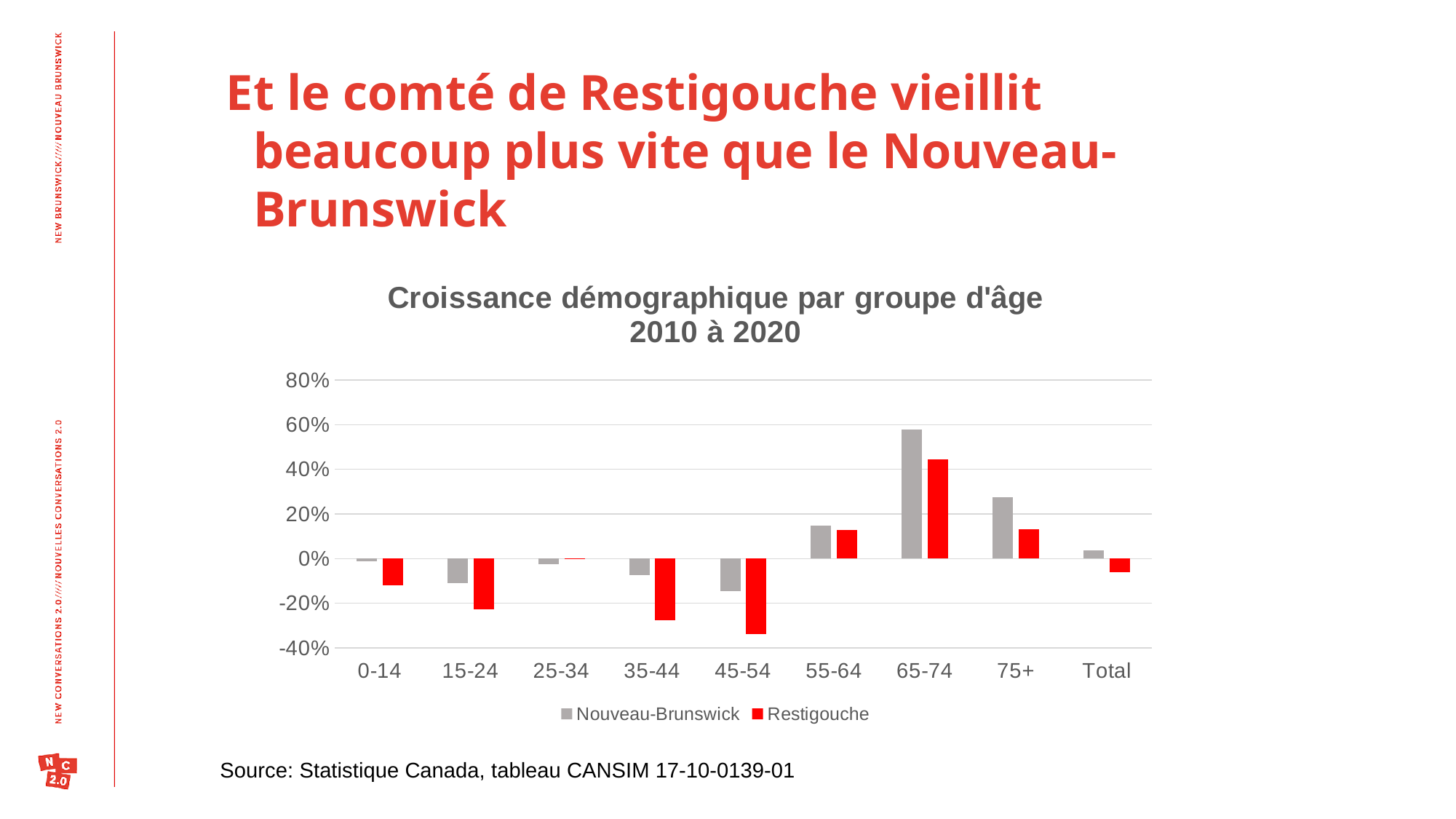
How many series does the legend list? 2 What kind of chart is shown on the slide? bar chart How many age-group categories (including Total) are shown on the x axis? 9 Is the Nouveau-Brunswick value for 65-74 greater or less than 40%? greater Is the Restigouche value for 45-54 greater or less than -20%? less What colour are the Restigouche bars? red For which age group is the Nouveau-Brunswick growth lowest? 45-54 For which age group is the Nouveau-Brunswick growth highest? 65-74 For the 15-24 age group, which series has the lower value, Nouveau-Brunswick or Restigouche? Restigouche For the 65-74 age group, which series has the larger value, Nouveau-Brunswick or Restigouche? Nouveau-Brunswick For which age group is the Restigouche growth highest? 65-74 For which age group is the Restigouche growth lowest? 45-54